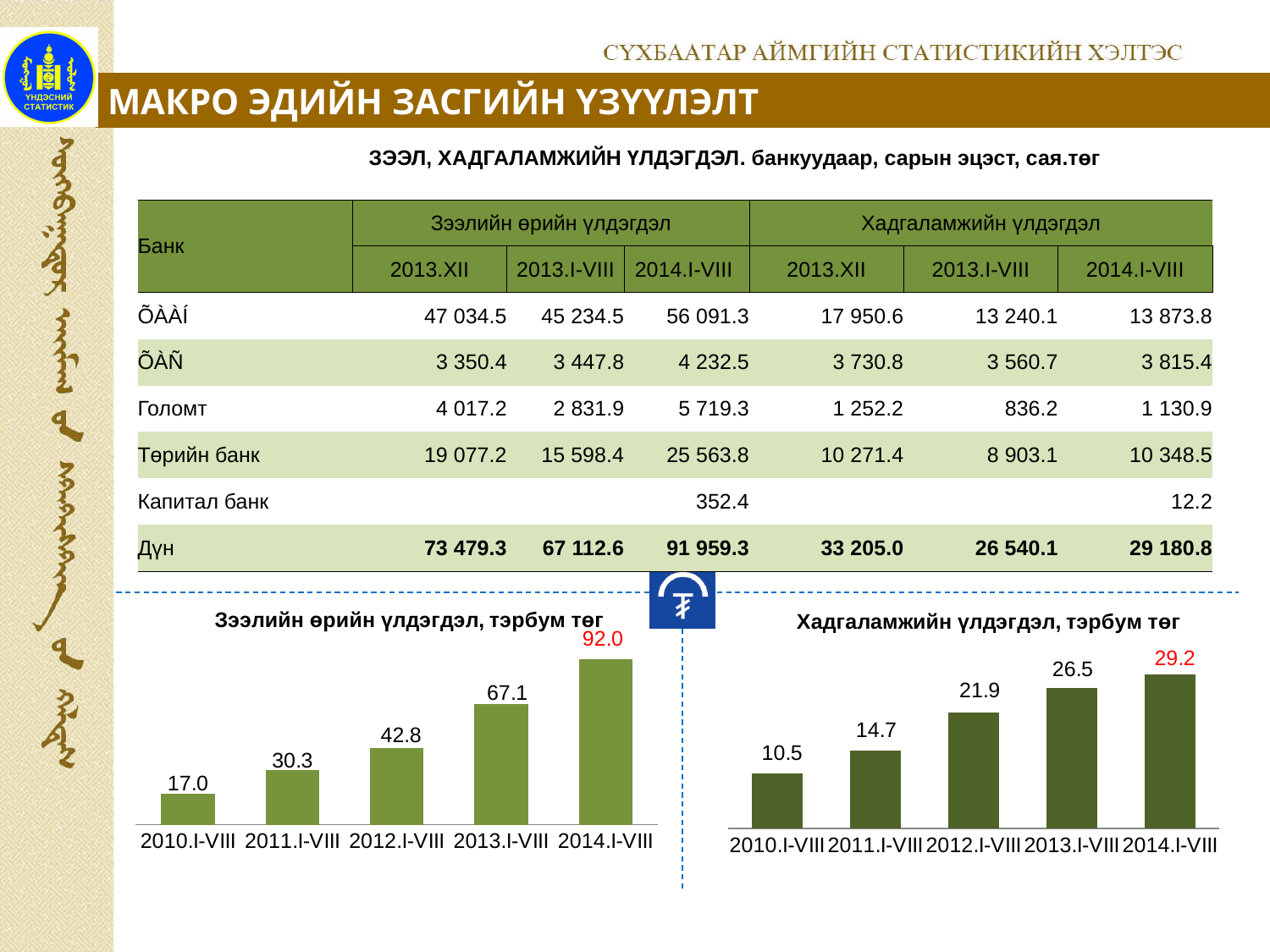
In the chart titled "Зээлийн өрийн үлдэгдэл, тэрбум төг", do the values rise or fall from 2010.I-VIII to 2014.I-VIII? Rise What is the title of the bar chart on the right side of the slide? Хадгаламжийн үлдэгдэл, тэрбум төг In the chart titled "Хадгаламжийн үлдэгдэл, тэрбум төг", which period has the lowest value? 2010.I-VIII In the chart titled "Зээлийн өрийн үлдэгдэл, тэрбум төг", what is the value for 2011.I-VIII? 30.3 In the chart titled "Зээлийн өрийн үлдэгдэл, тэрбум төг", what is the value for 2014.I-VIII? 92.0 In the chart titled "Хадгаламжийн үлдэгдэл, тэрбум төг", which is larger, the value for 2011.I-VIII or 2012.I-VIII? 2012.I-VIII In the chart titled "Зээлийн өрийн үлдэгдэл, тэрбум төг", which period has the highest value? 2014.I-VIII In the chart titled "Хадгаламжийн үлдэгдэл, тэрбум төг", what is the difference between the values for 2013.I-VIII and 2012.I-VIII? 4.6 How many bars are shown in the chart titled "Зээлийн өрийн үлдэгдэл, тэрбум төг"? 5 In the chart titled "Хадгаламжийн үлдэгдэл, тэрбум төг", what is the value for 2012.I-VIII? 21.9 In the chart titled "Зээлийн өрийн үлдэгдэл, тэрбум төг", what is the difference between the values for 2014.I-VIII and 2013.I-VIII? 24.9 What kind of chart is the chart titled "Хадгаламжийн үлдэгдэл, тэрбум төг"? Bar chart